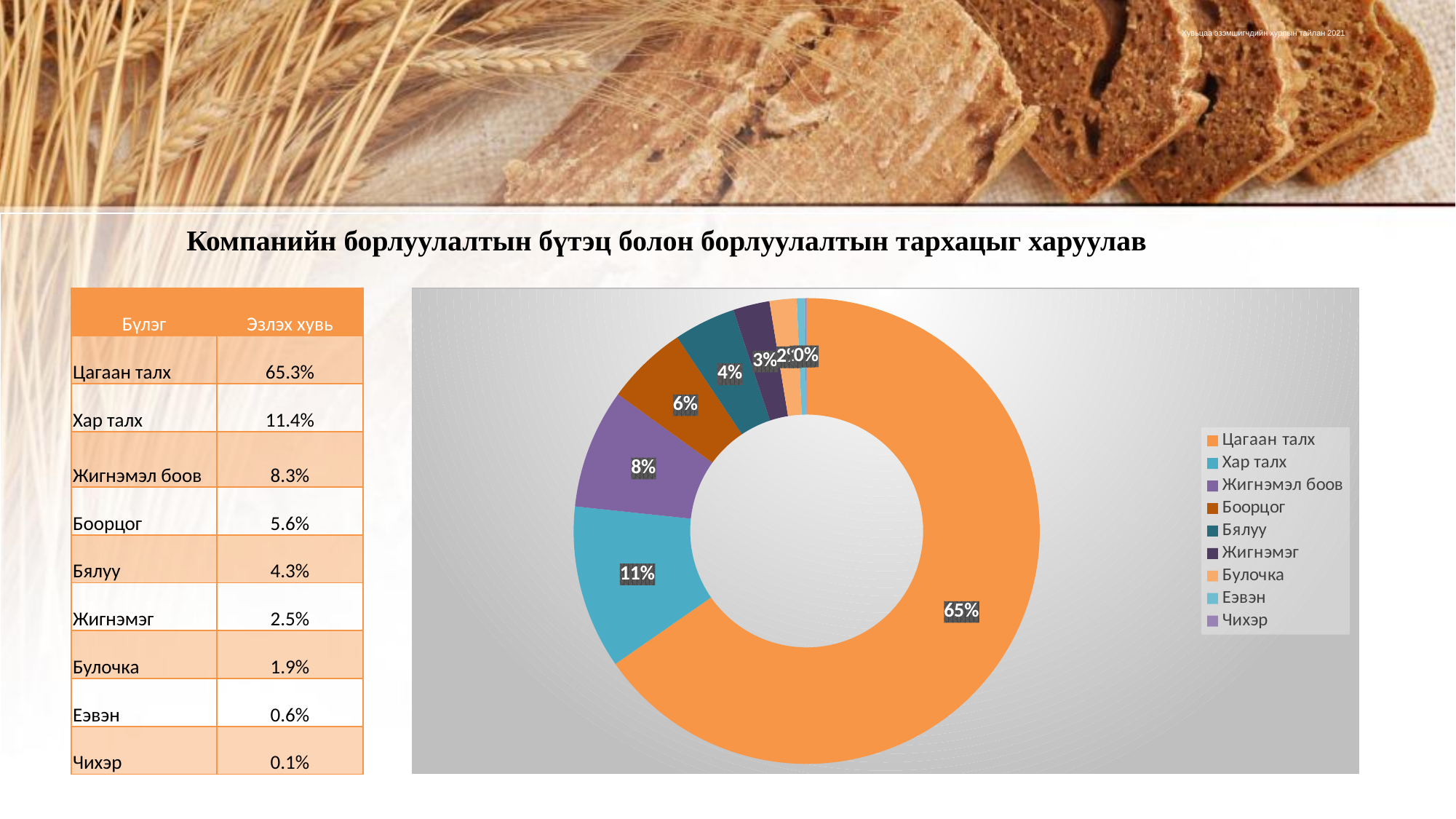
What percentage label is shown on the Боорцог slice of the chart? 6% What kind of chart is shown on the slide? Doughnut chart What is the difference between the chart labels for Жигнэмэл боов and Боорцог? 2% Which slice is larger in the chart, Хар талх or Жигнэмэл боов? Хар талх What percentage label is shown on the Цагаан талх slice of the chart? 65% Which category has the largest slice in the chart? Цагаан талх How many entries does the chart legend list? 9 What percentage label is shown on the Хар талх slice of the chart? 11% Which legend entry is shown in orange in the chart? Цагаан талх What percentage label is shown on the Бялуу slice of the chart? 4% What is the difference between the chart labels for Цагаан талх and Хар талх? 54% What percentage label is shown on the Жигнэмэл боов slice of the chart? 8%